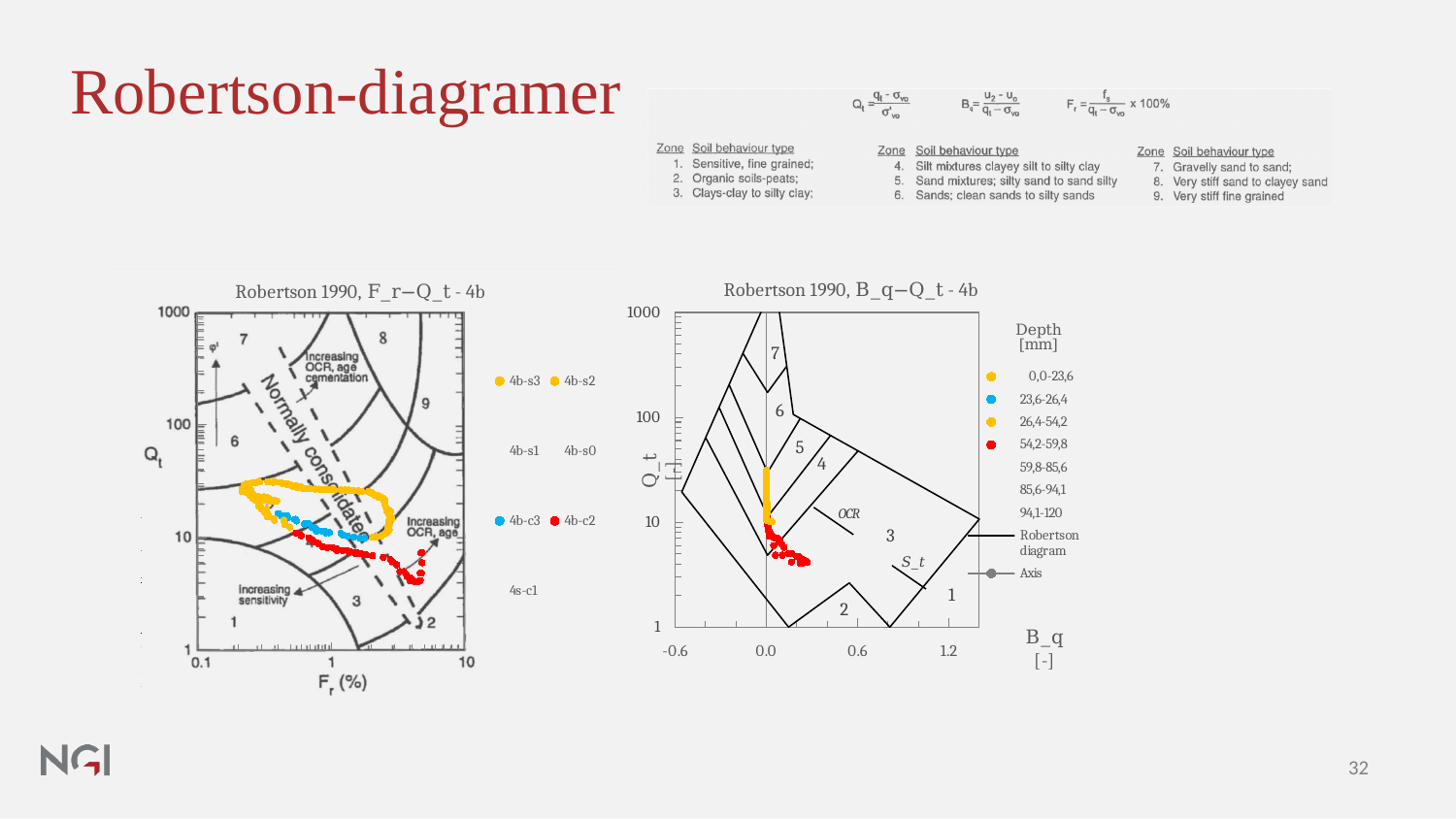
How many series does the legend of the left chart (F_r–Q_t) list? 7 In the right chart (B_q–Q_t), which is larger: the Q_t values of the yellow points or the Q_t values of the red points? yellow points What kind of chart is the left chart titled "Robertson 1990, F_r–Q_t - 4b"? scatter chart In the right chart (B_q–Q_t), what is the last depth range listed in the legend? 94,1-120 In the right chart (B_q–Q_t), what is the first depth range listed in the legend? 0,0-23,6 What kind of chart is the right chart titled "Robertson 1990, B_q–Q_t - 4b"? scatter chart How many depth ranges does the legend of the right chart (B_q–Q_t) list? 7 In the right chart (B_q–Q_t), are the Q_t values of the red points greater or less than 1? greater In the left chart (F_r–Q_t), which is larger: the Q_t values of the yellow points or the Q_t values of the red points? yellow points